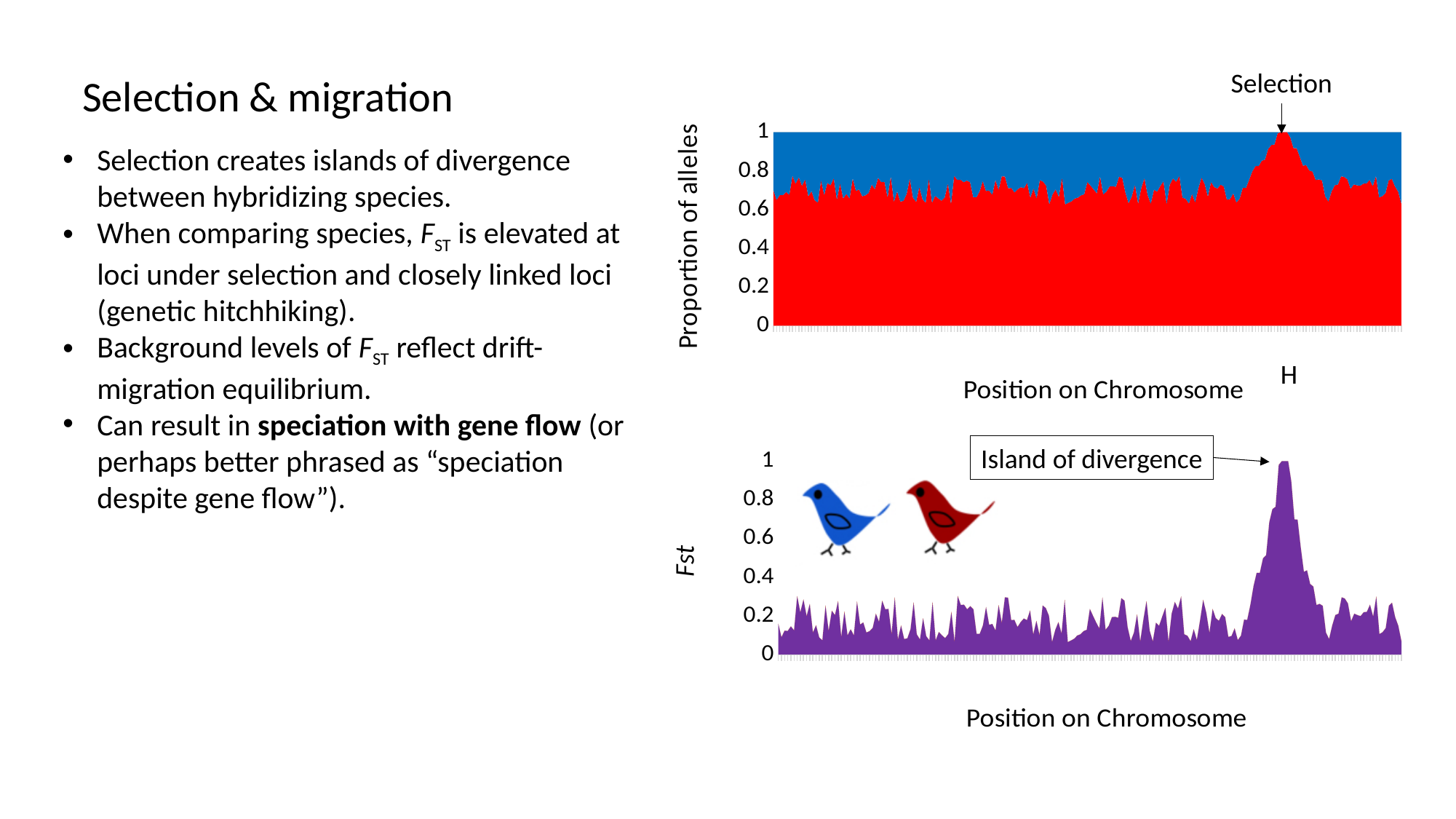
In the top chart (Proportion of alleles), is the red proportion at the position marked 'Selection' greater or less than 0.8? greater What is the y-axis label of the top chart on the slide? Proportion of alleles How many charts are shown on the slide? 2 In the bottom chart (Fst), what label does the arrow pointing to the tall peak carry? Island of divergence In the bottom chart (Fst), is the Fst value at the far left of the chromosome greater or less than 0.4? less What kind of chart is the top chart on the slide, labelled 'Proportion of alleles'? area chart In the top chart (Proportion of alleles), is the red proportion in the background regions away from the selection peak greater or less than 0.8? less What kind of chart is the bottom chart on the slide, labelled 'Fst'? area chart